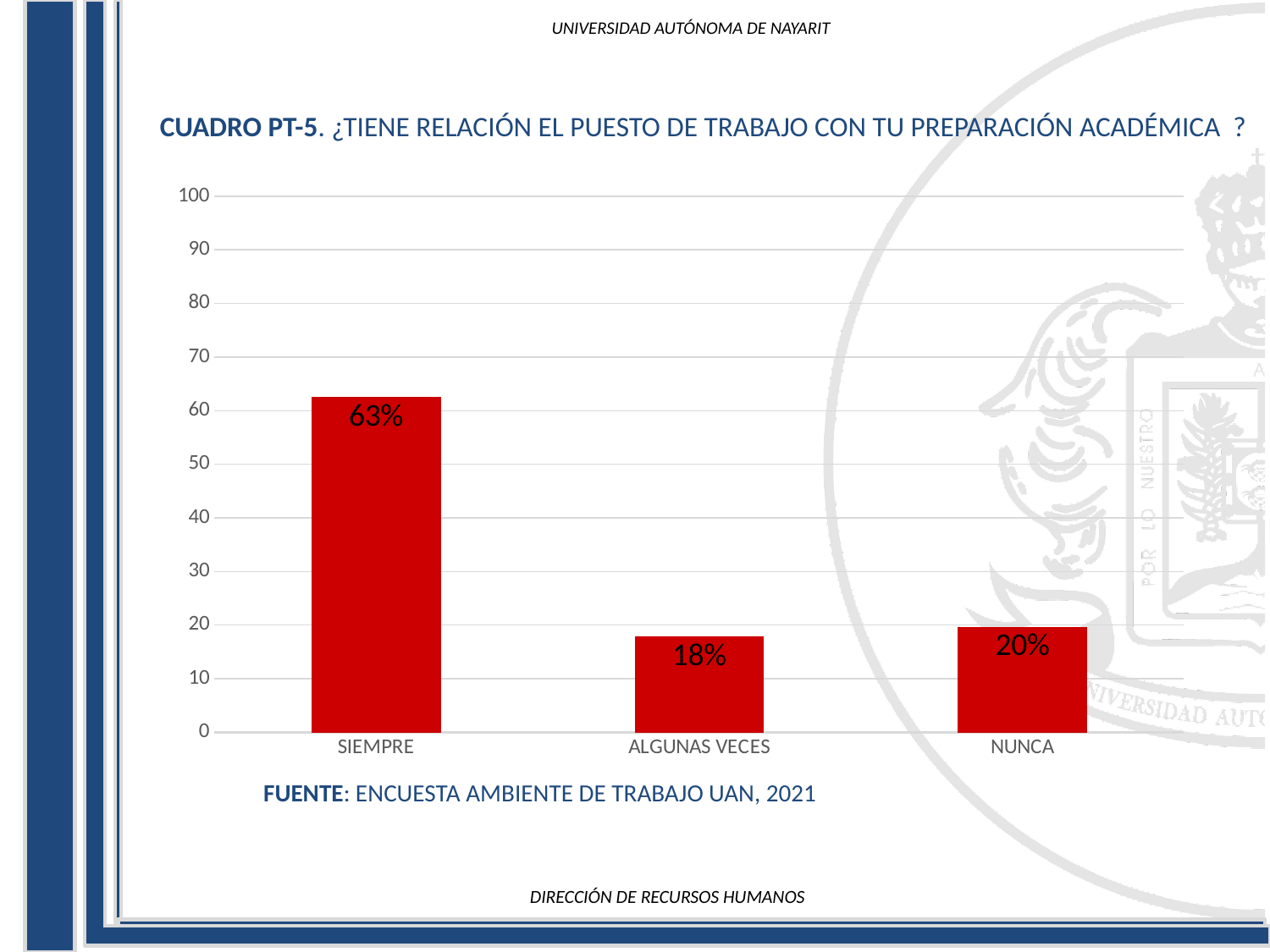
What is the difference between the values for NUNCA and ALGUNAS VECES? 2% What is the value for ALGUNAS VECES? 18% What is the value for SIEMPRE? 63% What source is cited below the chart? ENCUESTA AMBIENTE DE TRABAJO UAN, 2021 What kind of chart is shown on the slide? bar chart Which category has the lowest value? ALGUNAS VECES How many categories are shown on the x axis? 3 Which is larger, the value for NUNCA or the value for ALGUNAS VECES? NUNCA What is the difference between the values for SIEMPRE and NUNCA? 43% Which category has the highest value? SIEMPRE Is the value for SIEMPRE greater or less than 50? greater What is the value for NUNCA? 20%